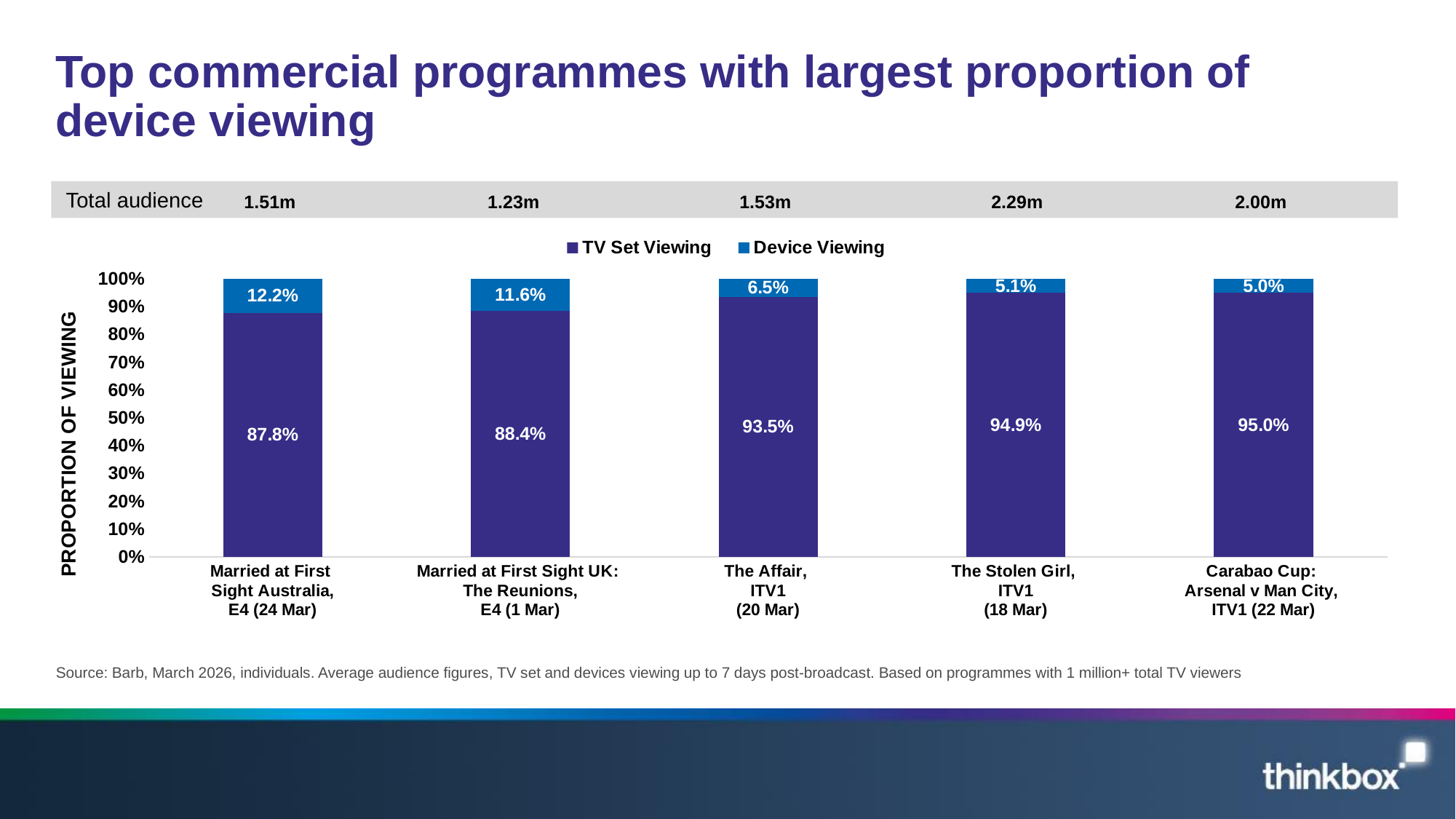
Which has a larger TV Set Viewing share, The Stolen Girl or The Affair? The Stolen Girl What is the Device Viewing share for Married at First Sight Australia, E4 (24 Mar)? 12.2% What is the Device Viewing share for Carabao Cup: Arsenal v Man City, ITV1 (22 Mar)? 5.0% How many programmes are shown on the chart? 5 Which programme has the highest Device Viewing share? Married at First Sight Australia, E4 (24 Mar) How many series does the legend list? 2 What is the TV Set Viewing share for The Affair, ITV1 (20 Mar)? 93.5% Does the Device Viewing share rise or fall moving from left to right across the programmes? Fall What is the difference in Device Viewing share between Married at First Sight Australia and Married at First Sight UK: The Reunions? 0.6% What is the total audience shown for The Stolen Girl, ITV1 (18 Mar)? 2.29m Which programme has the lowest Device Viewing share? Carabao Cup: Arsenal v Man City, ITV1 (22 Mar) What kind of chart is shown on the slide? Stacked bar chart